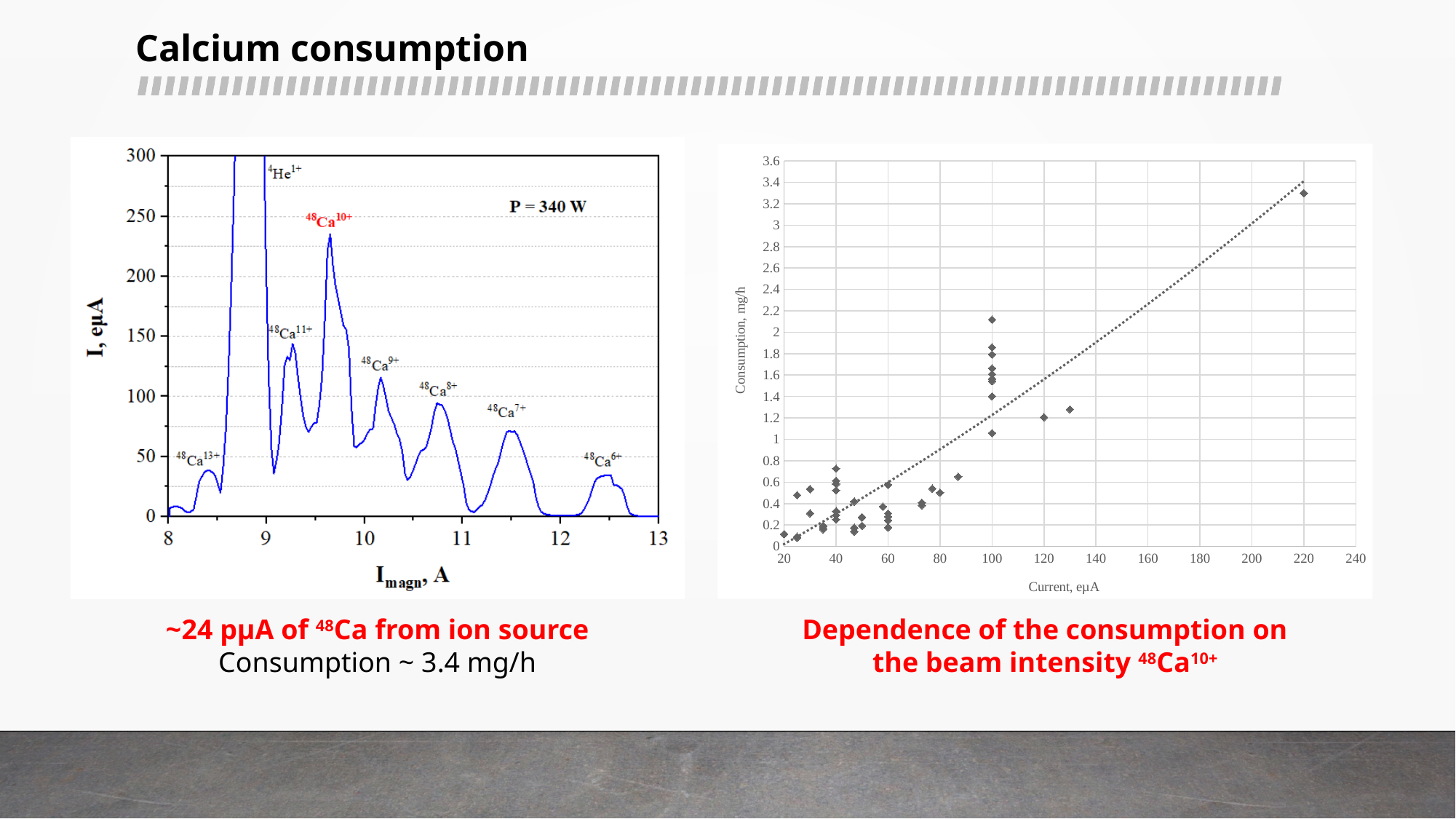
On the right chart, is the consumption value at a current of 220 eμA greater or less than 3? greater On the left chart, what power value is annotated on the plot? P = 340 W On the right chart, what is the label of the y axis? Consumption, mg/h On the left chart, is the peak value for 48Ca7+ greater or less than 100? less On the left chart, how many labelled peaks are there in total? 8 What kind of chart is the left chart (I, eμA versus I_magn, A)? line chart On the left chart, is the peak value for 48Ca10+ greater or less than 200? greater On the left chart, which labelled calcium charge state has the highest peak? 48Ca10+ On the right chart, at which current (eμA) is the highest consumption point plotted? 220 What kind of chart is the right chart (Consumption, mg/h versus Current, eμA)? scatter chart On the left chart, which peak is higher, 48Ca9+ or 48Ca8+? 48Ca9+ On the right chart, does consumption generally rise or fall as current increases? rise